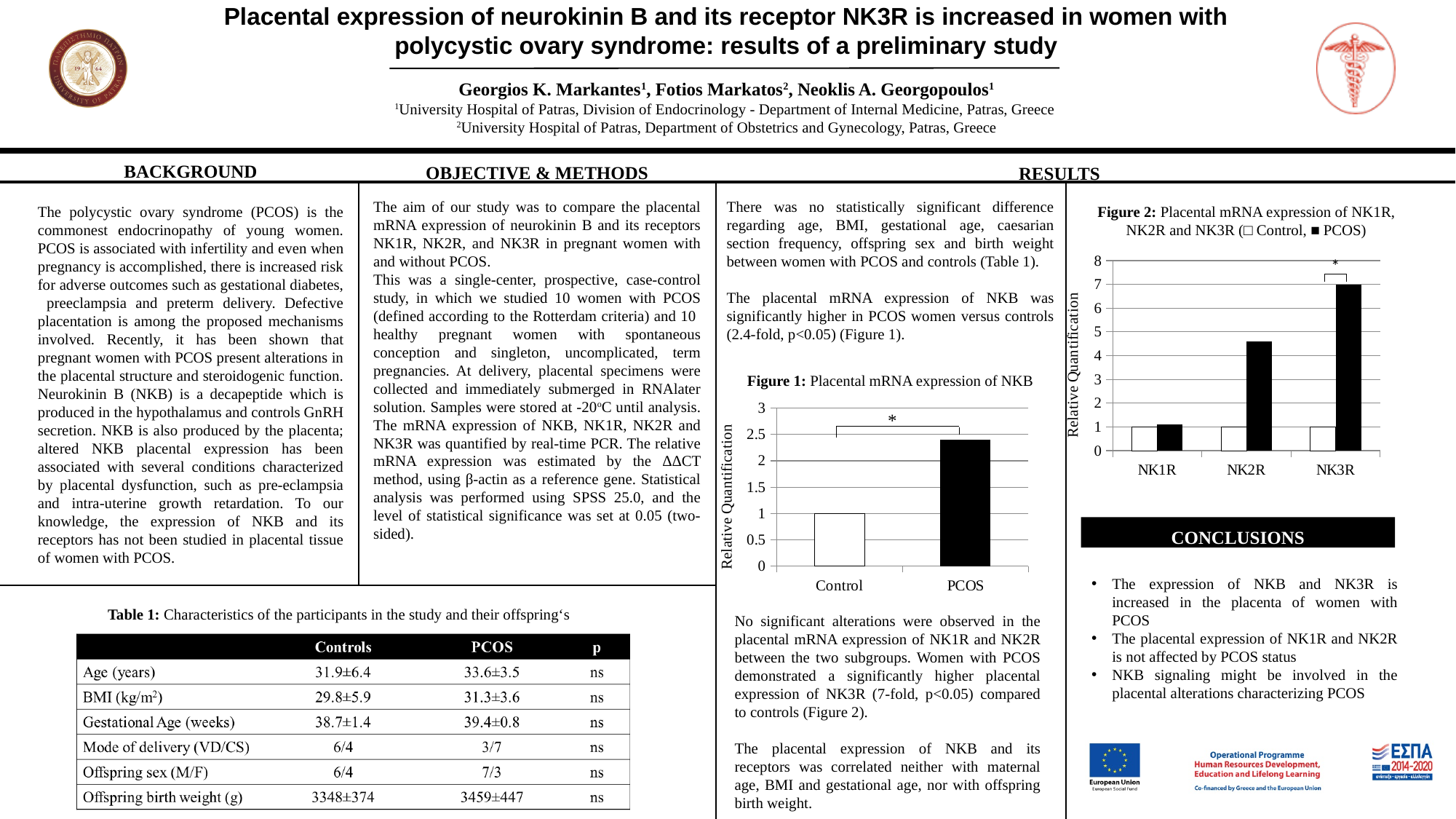
In Figure 2, which series is shown with black bars? PCOS In Figure 1, which category has the higher relative quantification, Control or PCOS? PCOS In Figure 1, how many categories are shown on the x axis? 2 In Figure 2, how many categories are shown on the x axis? 3 What kind of chart is Figure 1? Bar chart In Figure 2, how many series are plotted? 2 In Figure 1, is the value for PCOS greater or less than 2? greater In Figure 1, what is the relative quantification value for Control? 1 In Figure 2, is the PCOS value for NK2R greater or less than 5? less In Figure 2, what is the relative quantification value for PCOS in the NK3R category? 7 In Figure 2, which category has the highest PCOS value? NK3R In Figure 2, is the PCOS value for NK2R greater or less than 4? greater